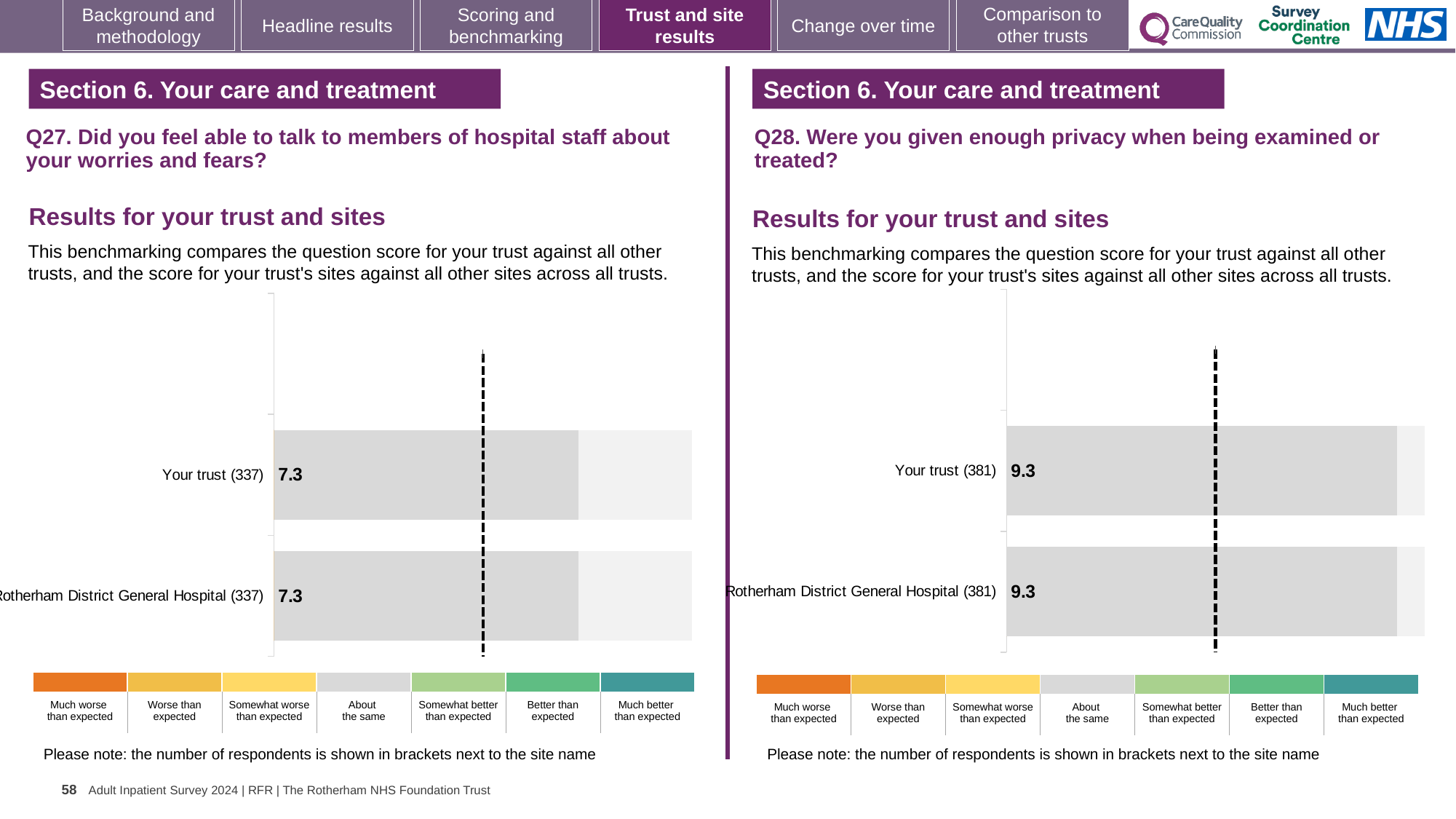
Is the score for Your trust on the Q28 chart (right) larger or smaller than the score for Your trust on the Q27 chart (left)? Larger On the Q27 chart (left), what is the difference between the score for Your trust and the score for Rotherham District General Hospital? 0.0 On the Q27 chart (left), what is the score for Your trust? 7.3 On the Q28 chart (right), what is the score for Rotherham District General Hospital? 9.3 On the Q28 chart (right), what is the score for Your trust? 9.3 What kind of chart is used on the Q27 chart (left)? Bar chart On the Q27 chart (left), how many respondents are shown in brackets next to Your trust? 337 On the Q28 chart (right), what is the difference between the score for Your trust and the score for Rotherham District General Hospital? 0.0 How many bars are plotted on the Q28 chart (right)? 2 On the Q27 chart (left), what is the score for Rotherham District General Hospital? 7.3 On the Q28 chart (right), how many respondents are shown in brackets next to Rotherham District General Hospital? 381 How many bars are plotted on the Q27 chart (left)? 2